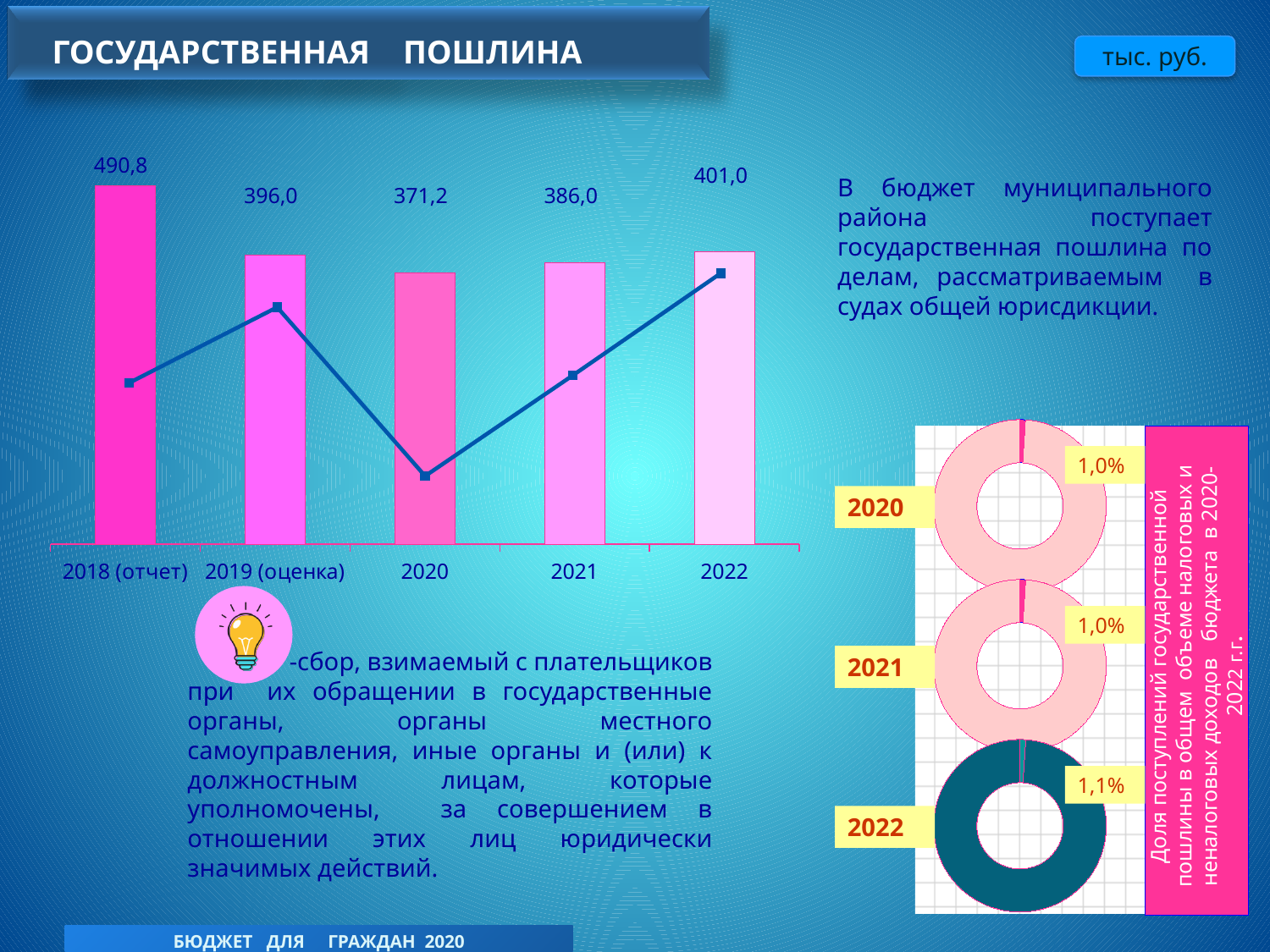
In the bar chart on the left, which category has the highest value? 2018 (отчет) In the bar chart on the left, which is larger, the value for 2021 or the value for 2022? 2022 In the donut charts on the right, what share is shown for 2020? 1,0% In the bar chart on the left, what is the value for 2022? 401,0 What kind of chart is the chart on the left of the slide? bar chart In the bar chart on the left, what is the difference between the values for 2018 (отчет) and 2019 (оценка)? 94,8 In the donut charts on the right, what share is shown for 2022? 1,1% In the bar chart on the left, what is the value for 2018 (отчет)? 490,8 In the bar chart on the left, do the values rise or fall from 2020 to 2022? rise How many categories are shown on the x axis of the bar chart on the left? 5 In the bar chart on the left, which category has the lowest value? 2020 In the bar chart on the left, what is the value for 2020? 371,2